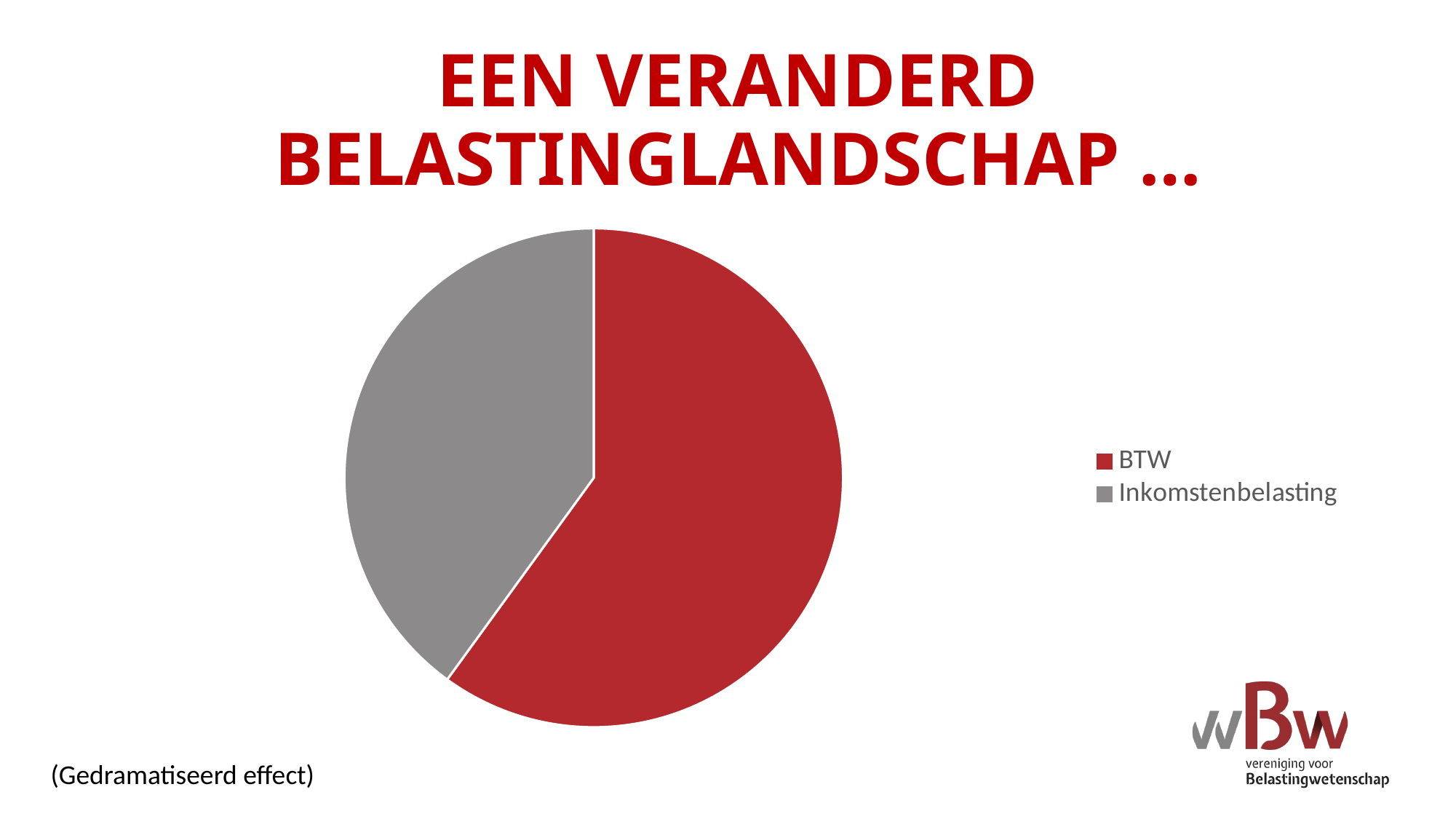
Which slice of the pie chart is the smallest? Inkomstenbelasting Which is larger in the pie chart, BTW or Inkomstenbelasting? BTW Which slice of the pie chart is the largest? BTW Does the BTW slice take up more or less than half of the pie chart? More How many slices does the pie chart have? 2 What kind of chart is shown on the slide? Pie chart What colour is the BTW slice in the pie chart? Red Which legend entry is shown in grey? Inkomstenbelasting How many entries does the legend of the pie chart list? 2